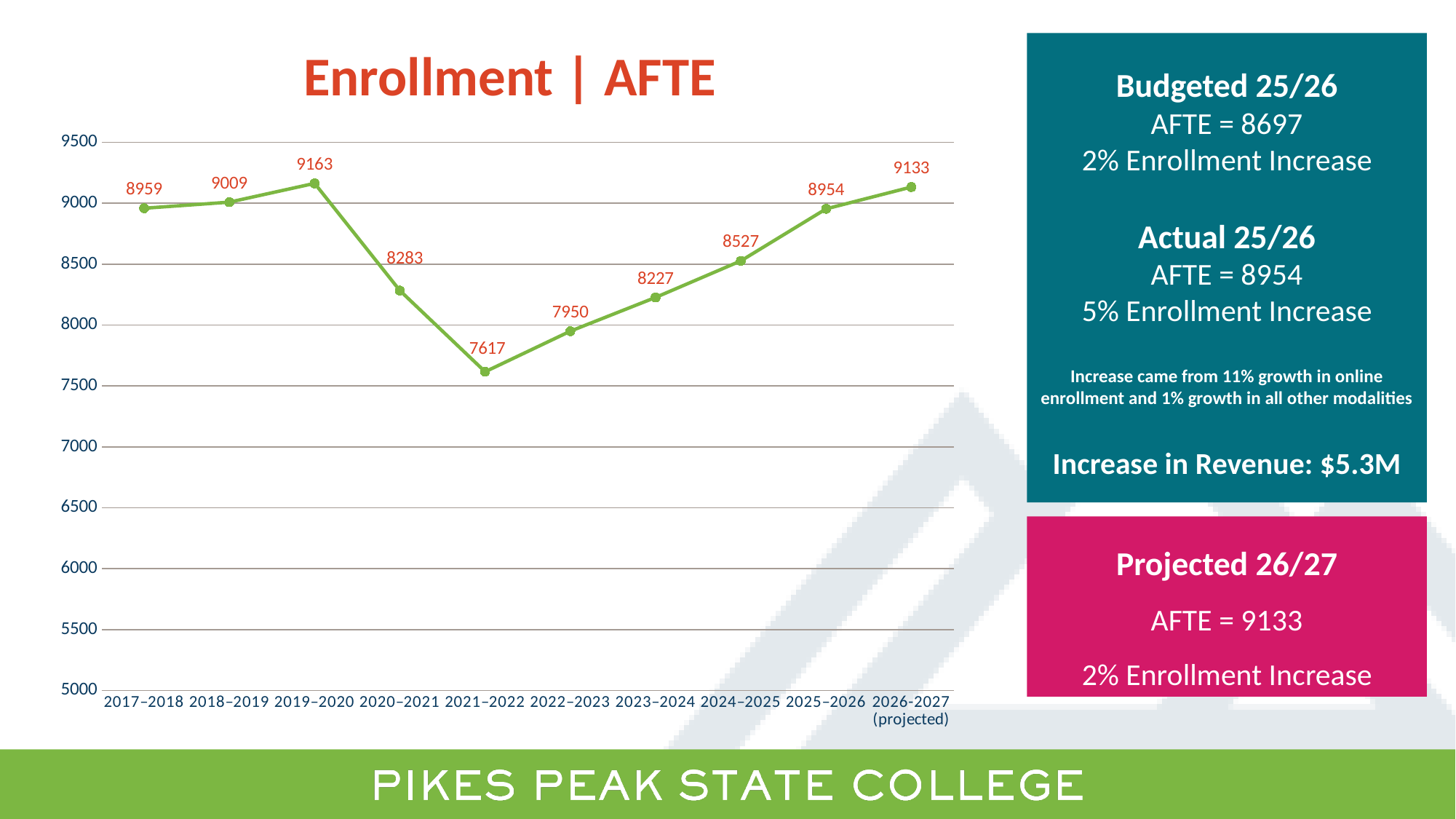
How many years are plotted on the chart? 10 Do the AFTE values rise or fall from 2021–2022 to 2026-2027? rise What is the difference between the AFTE values for 2025–2026 and 2024–2025? 427 Which year has the highest AFTE value? 2019–2020 Which is larger, the AFTE value for 2018–2019 or for 2025–2026? 2018–2019 Is the AFTE value for 2022–2023 greater or less than 8000? less Which year has the lowest AFTE value? 2021–2022 What kind of chart is shown on the slide? line chart What is the projected AFTE value for 2026-2027? 9133 What is the title of the chart? Enrollment | AFTE What is the AFTE value for 2019–2020? 9163 What is the AFTE value for 2021–2022? 7617